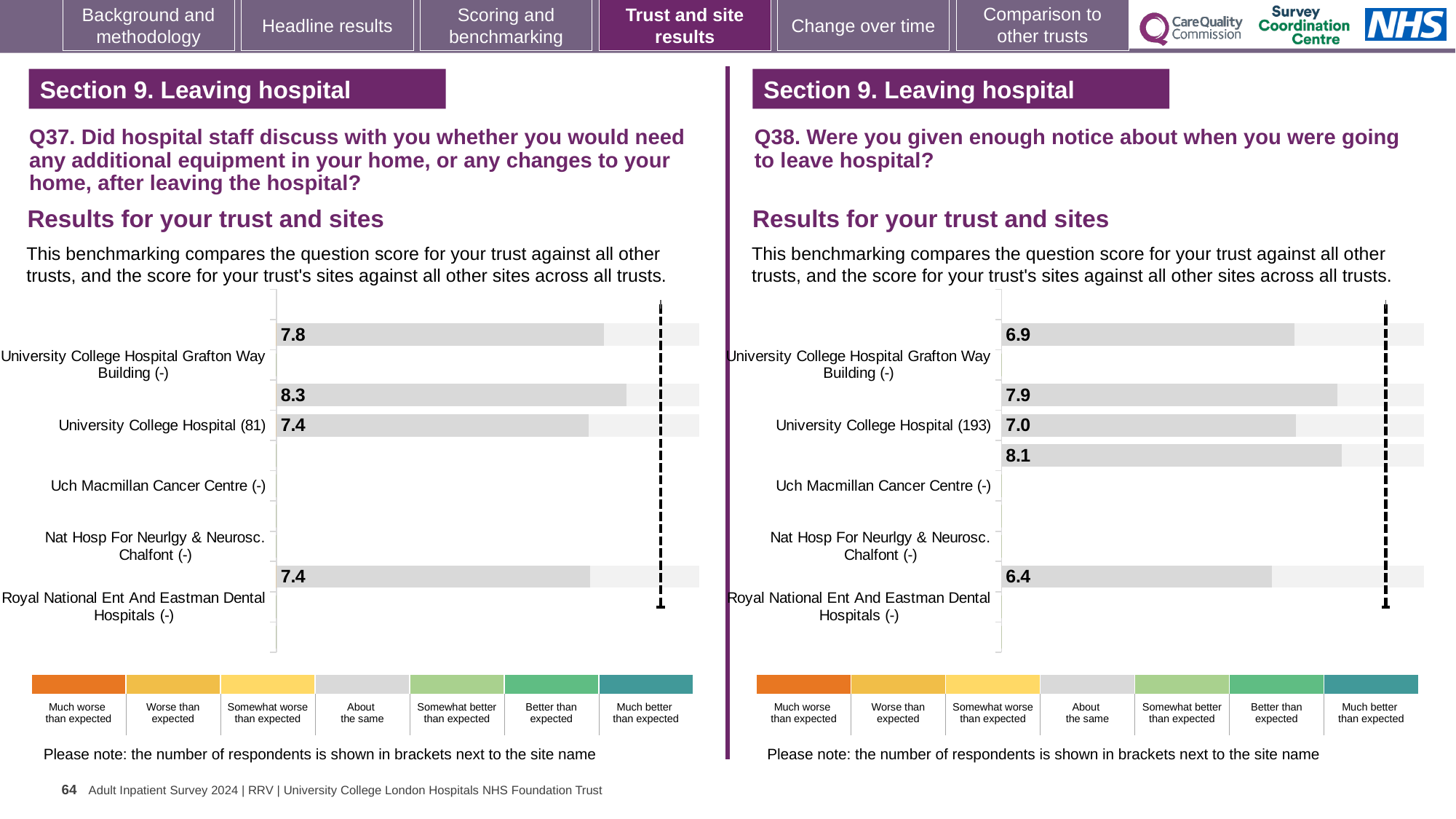
On the Q38 chart, what is the lowest score printed on a bar? 6.4 On the Q37 chart, what is the difference between the highest printed score (8.3) and the lowest printed score (7.4)? 0.9 On the Q37 chart, what score is shown on the bar aligned with University College Hospital (81)? 7.4 How many site names are listed on the vertical axis of the Q38 chart? 5 On the Q38 chart, what is the difference between the highest printed score (8.1) and the lowest printed score (6.4)? 1.7 What kind of chart is used on the left (Q37) side of the slide? bar chart How many categories does the colour legend below the Q37 chart list, from 'Much worse than expected' to 'Much better than expected'? 7 On the Q37 chart, what is the highest score printed on a bar? 8.3 On the Q38 chart, what is the highest score printed on a bar? 8.1 On the Q37 chart, what is the lowest score printed on a bar? 7.4 On the Q38 chart, what score is shown on the bar aligned with University College Hospital (193)? 7.0 According to the Q38 chart's axis label, how many respondents are shown in brackets for University College Hospital? 193